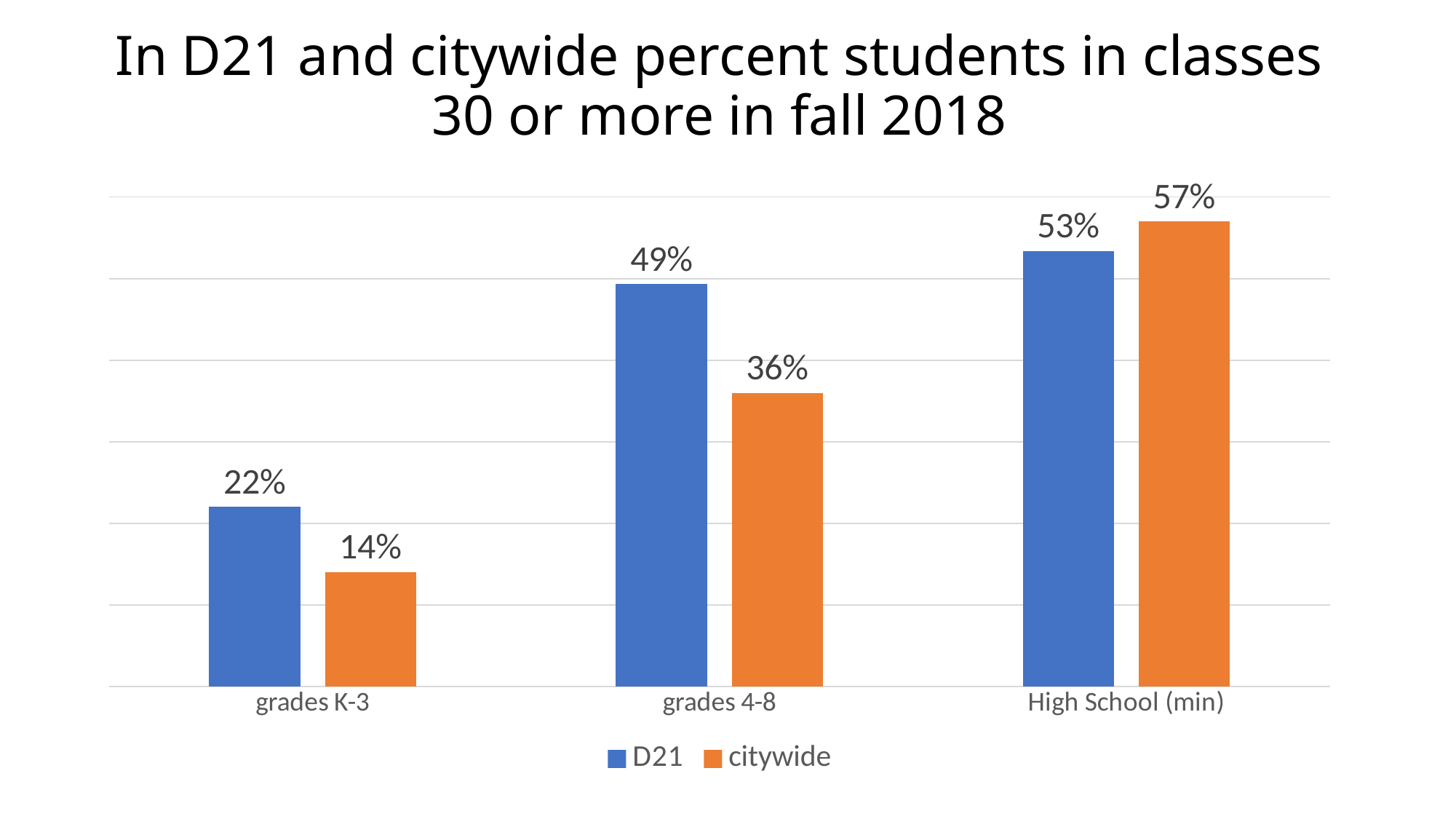
What is the D21 value for High School (min)? 53% How many series does the legend list? 2 What kind of chart is shown on the slide? bar chart Which colour represents the citywide series? orange For High School (min), which is larger, the D21 value or the citywide value? citywide What is the difference between the D21 and citywide values for grades 4-8? 13% What is the D21 value for grades K-3? 22% What is the citywide value for grades 4-8? 36% How many grade categories are shown on the x axis? 3 Which category has the lowest citywide value? grades K-3 What is the citywide value for High School (min)? 57% Which category has the highest D21 value? High School (min)